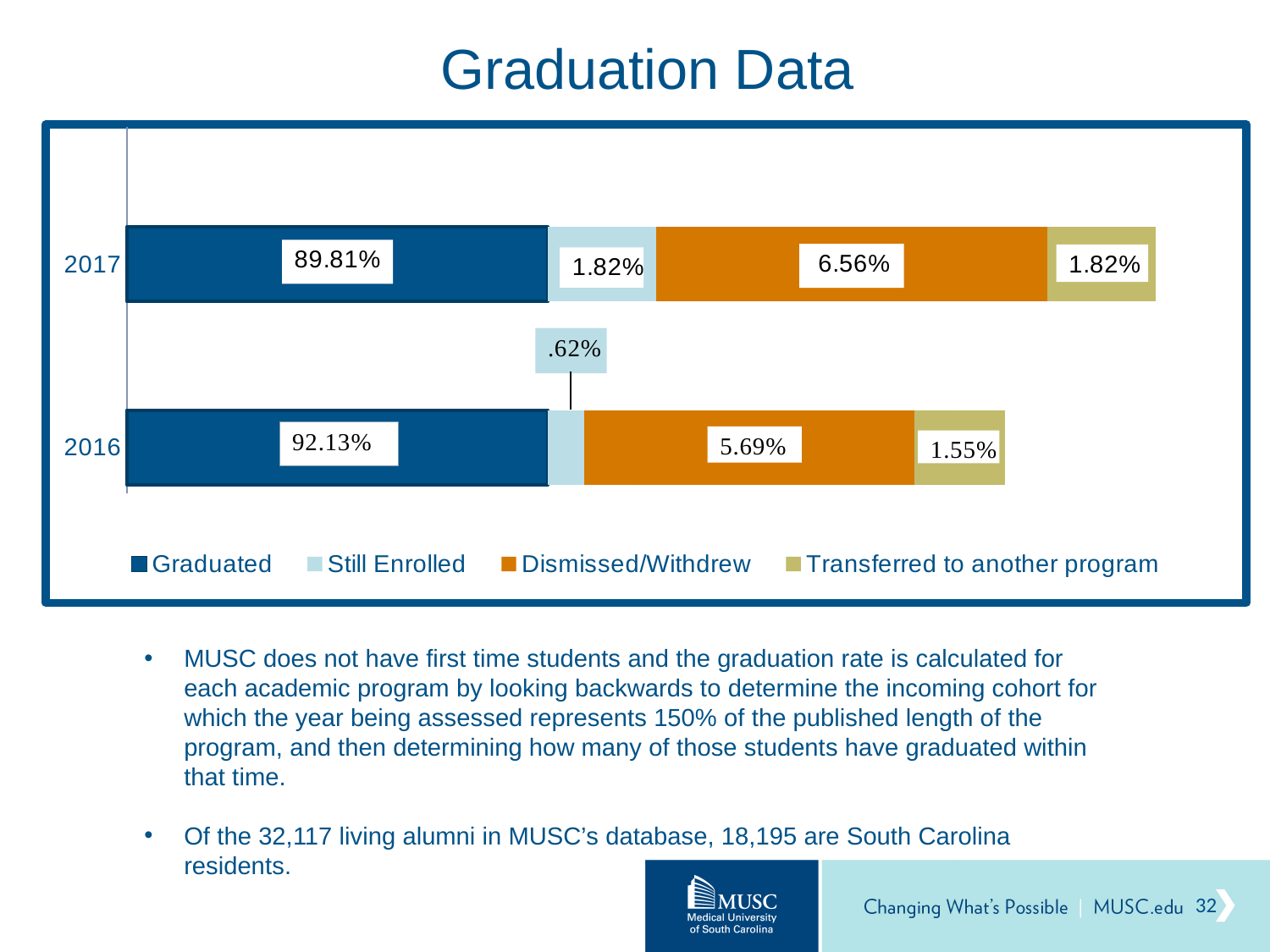
What kind of chart is shown on the slide? Stacked bar chart What is the difference in the Graduated percentage between 2016 and 2017? 2.32 percentage points Which year has the higher Graduated percentage? 2016 What is the Graduated value for 2017? 89.81% What is the Dismissed/Withdrew value for 2017? 6.56% How many series does the legend list? 4 What is the Transferred to another program value for 2016? 1.55% How many years are shown in the chart? 2 What is the Graduated value for 2016? 92.13% Which year has the higher Dismissed/Withdrew percentage? 2017 What is the difference in the Dismissed/Withdrew percentage between 2017 and 2016? 0.87 percentage points What is the Still Enrolled value for 2016? .62%